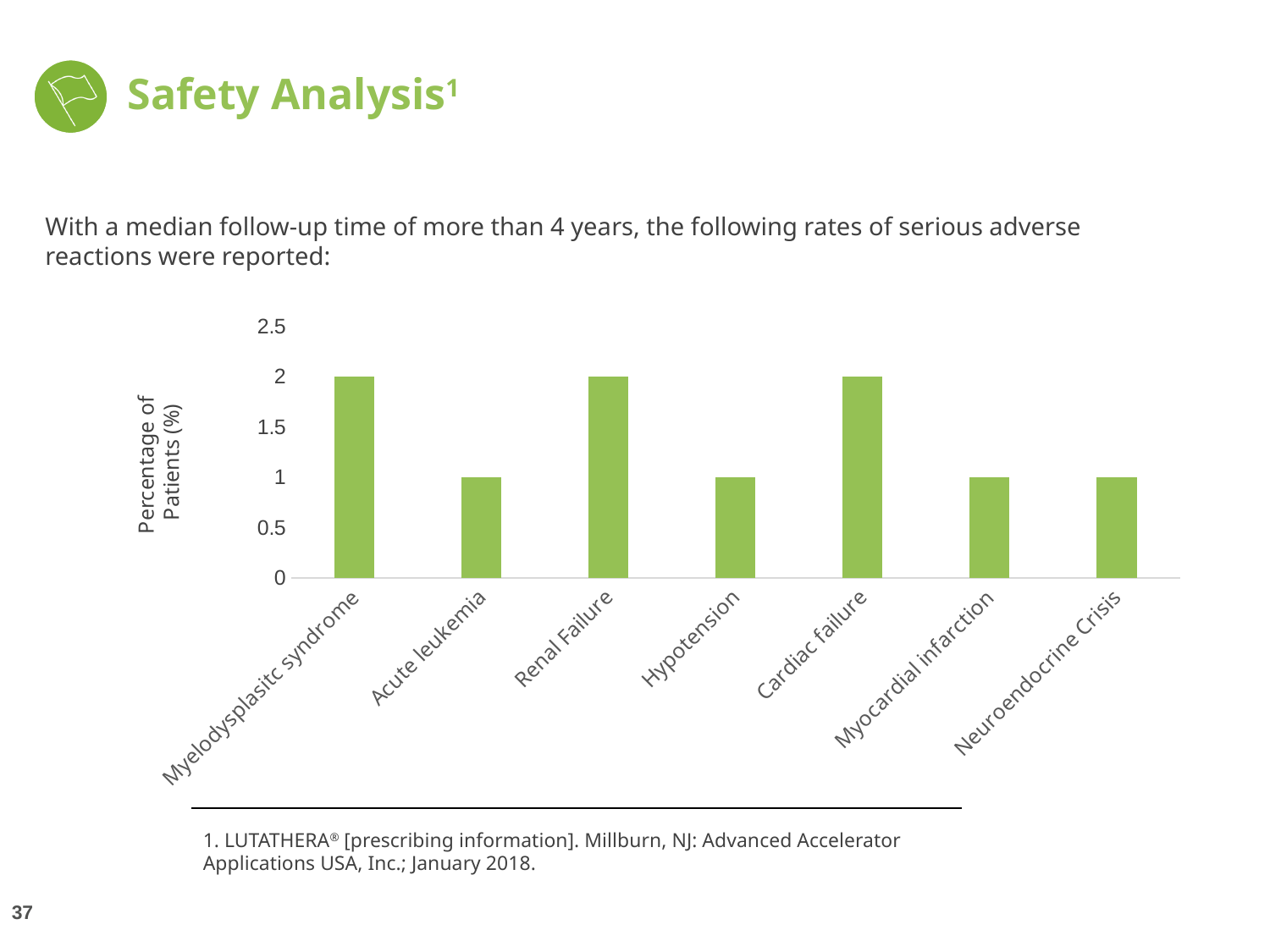
What is the label of the vertical axis of the chart? Percentage of Patients (%) How many categories are shown on the x axis of the chart? 7 What is the value for Myelodysplasitc syndrome? 2 What is the value for Cardiac failure? 2 Is the value for Cardiac failure greater or less than 1.5? greater What kind of chart is shown on the slide? bar chart Which is larger, the value for Renal Failure or the value for Hypotension? Renal Failure Is the value for Acute leukemia greater or less than 1.5? less What is the value for Acute leukemia? 1 What is the difference between the value for Renal Failure and the value for Hypotension? 1 What is the value for Neuroendocrine Crisis? 1 Which is larger, the value for Myocardial infarction or the value for Cardiac failure? Cardiac failure